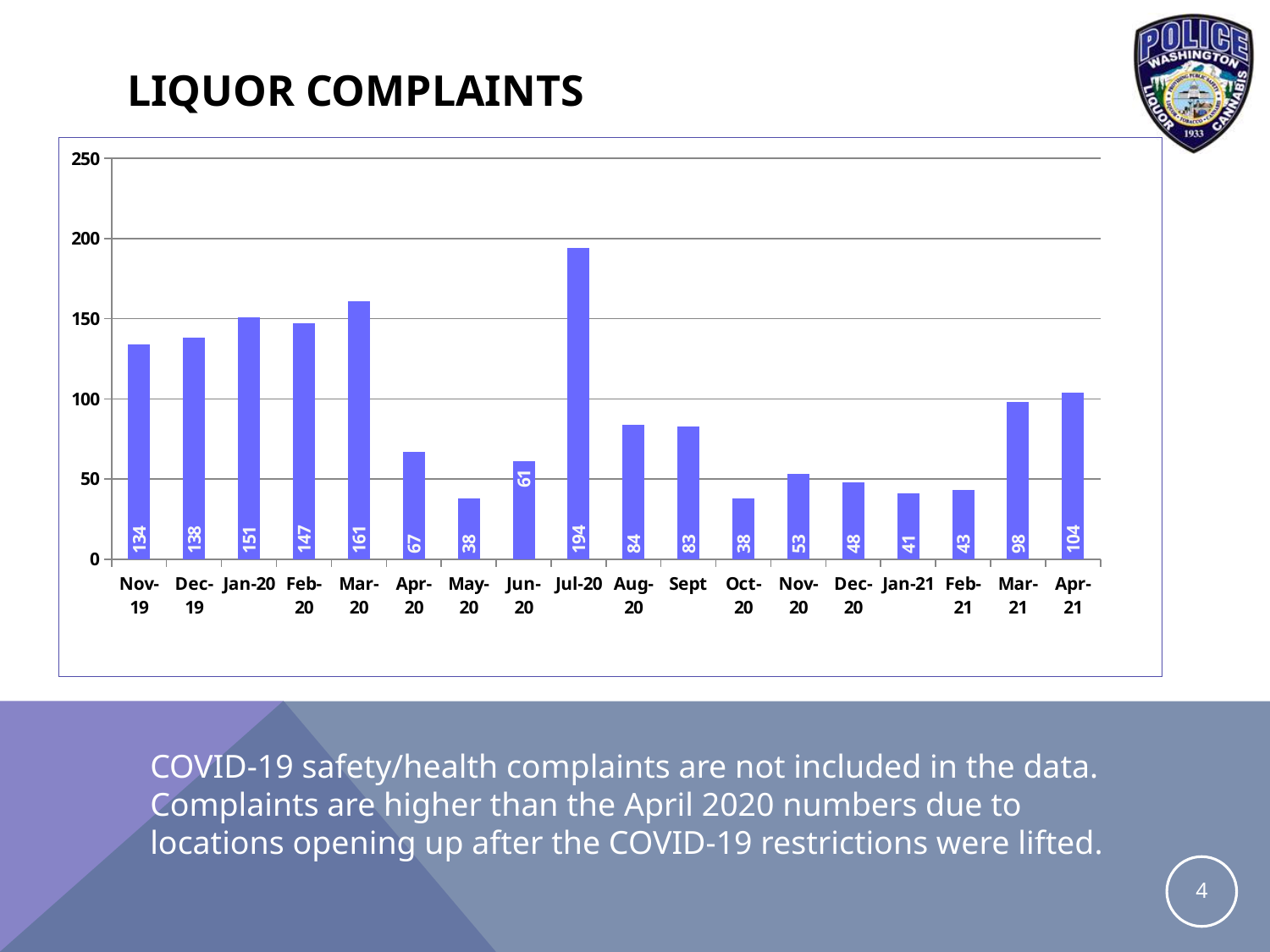
What is the value for Mar-20? 161 Which is larger, the value for Mar-21 or the value for Apr-21? Apr-21 Is the value for Jan-20 greater or less than 150? greater What is the title of the slide's chart? LIQUOR COMPLAINTS Which month has the highest number of liquor complaints? Jul-20 What is the value for Apr-21? 104 What kind of chart is shown on the slide? bar chart What is the difference between the values for Jul-20 and Aug-20? 110 Do the values rise or fall from Nov-20 to Apr-21? rise How many months are shown on the x axis? 18 What is the value for Jul-20? 194 Which month has the lowest number of liquor complaints? May-20 and Oct-20 (38)